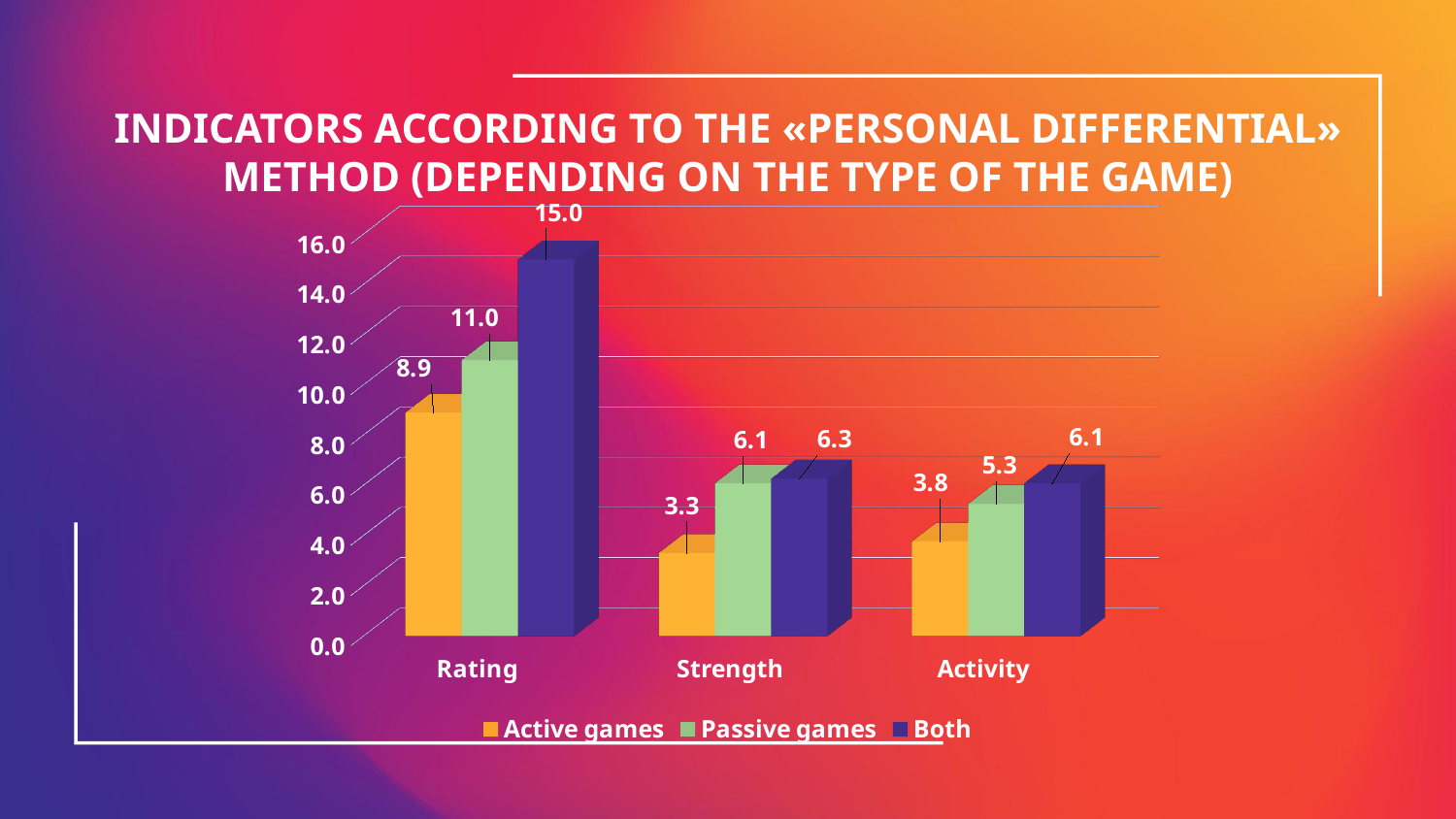
Which is larger in the Strength category: Active games or Passive games? Passive games What kind of chart is shown on the slide? Bar chart Which category has the lowest value for Active games? Strength Which series is shown in green in the legend? Passive games What is the difference between the Both and Active games values in the Rating category? 6.1 How many categories are shown on the x axis? 3 What is the value for Active games in the Rating category? 8.9 What is the difference between Passive games and Active games in the Activity category? 1.5 What is the value for Passive games in the Activity category? 5.3 What is the value for Both in the Strength category? 6.3 How many series does the legend list? 3 Which category has the highest value for the Both series? Rating